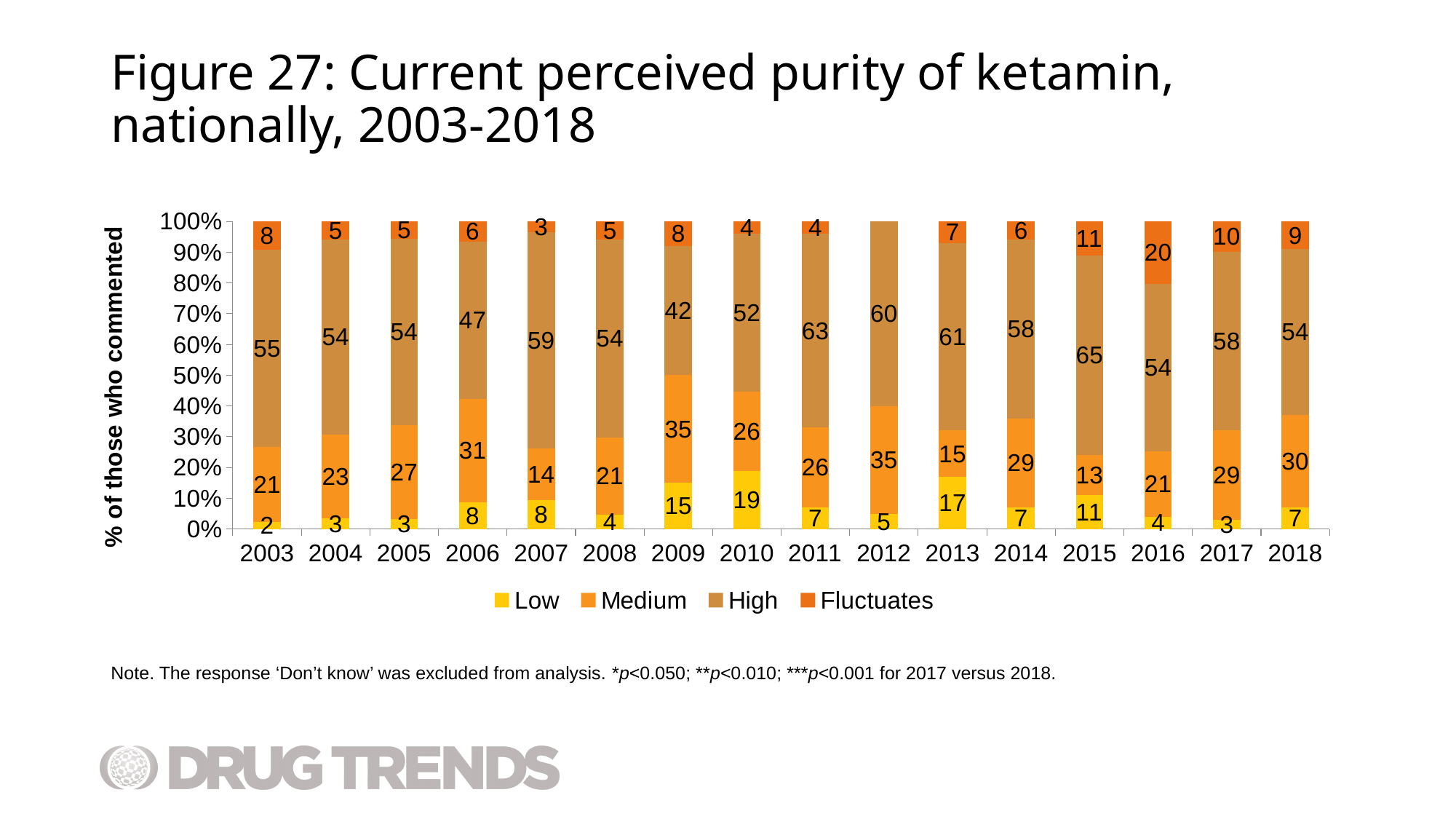
In which year is the Low series highest? 2010 What is the value for Low in 2018? 7 What is the difference between the High value in 2015 and the High value in 2009? 23 In which year is the Low series lowest? 2003 How many series does the legend list? 4 What percentage of those who commented rated ketamine purity as High in 2015? 65 How many years are shown on the x axis? 16 What is the value for Fluctuates in 2016? 20 Which is larger, the Medium value in 2013 or the Medium value in 2014? 2014 What kind of chart is shown on the slide? Stacked bar chart In which year is the Fluctuates series highest? 2016 What is the value for Medium in 2009? 35